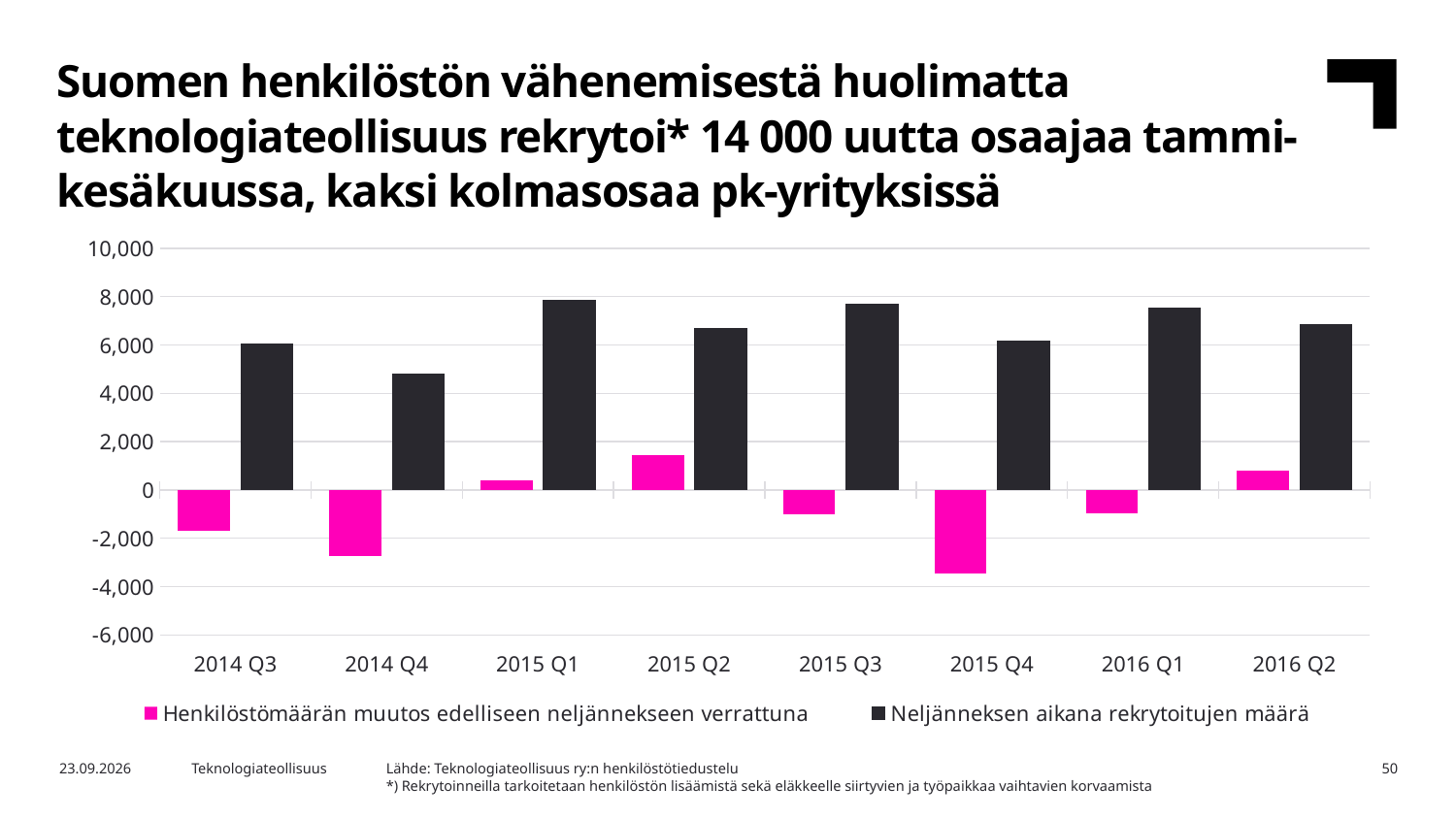
In which quarter is the value for 'Neljänneksen aikana rekrytoitujen määrä' lowest? 2014 Q4 Which quarter has the larger value for 'Neljänneksen aikana rekrytoitujen määrä', 2014 Q3 or 2014 Q4? 2014 Q3 Is the value for 'Henkilöstömäärän muutos edelliseen neljännekseen verrattuna' in 2015 Q4 greater or less than -2,000? less Is the value for 'Neljänneksen aikana rekrytoitujen määrä' in 2015 Q1 greater or less than 6,000? greater Is the value for 'Neljänneksen aikana rekrytoitujen määrä' in 2014 Q4 greater or less than 6,000? less In which quarter is the value for 'Henkilöstömäärän muutos edelliseen neljännekseen verrattuna' highest? 2015 Q2 In which quarter is the value for 'Henkilöstömäärän muutos edelliseen neljännekseen verrattuna' lowest? 2015 Q4 What kind of chart is shown on the slide? bar chart Which quarter has the larger value for 'Henkilöstömäärän muutos edelliseen neljännekseen verrattuna', 2015 Q2 or 2015 Q3? 2015 Q2 How many series does the chart legend list? 2 Which colour represents the series 'Henkilöstömäärän muutos edelliseen neljännekseen verrattuna' in the chart? pink (magenta) How many quarters are shown on the x axis of the chart? 8